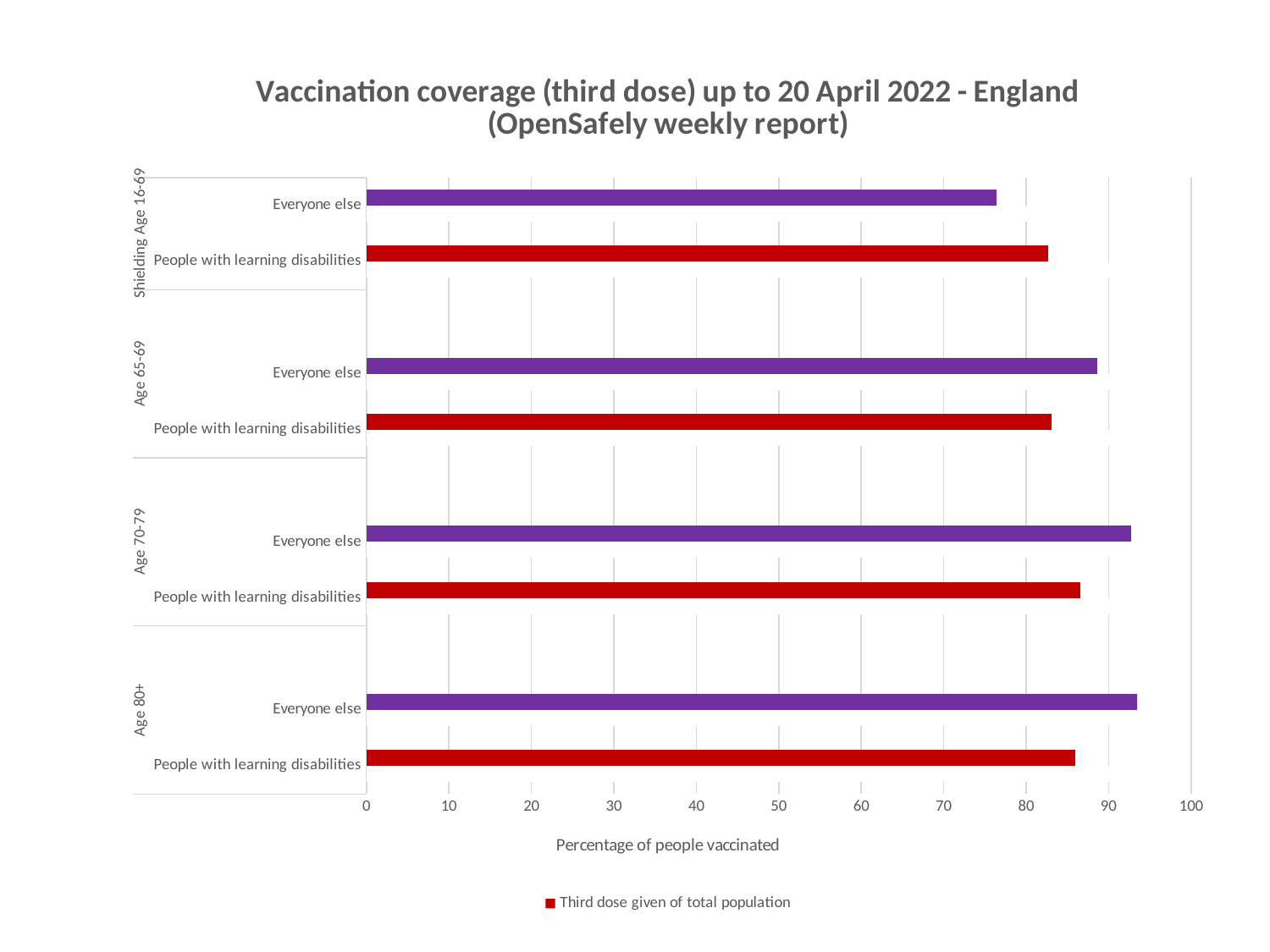
Is the value for Everyone else in the Age 65-69 group greater or less than 90? less How many series does the legend list? 1 Is the value for Everyone else in the Age 80+ group greater or less than 90? greater What is the title of the horizontal axis of the chart? Percentage of people vaccinated Is the value for People with learning disabilities in the Age 80+ group greater or less than 80? greater How many bars are plotted in the chart? 8 What kind of chart is shown on the slide? Bar chart In the Age 70-79 group, which is larger: the value for People with learning disabilities or for Everyone else? Everyone else In the Shielding Age 16-69 group, which is larger: the value for People with learning disabilities or for Everyone else? People with learning disabilities Which bar has the lowest value in the chart? Everyone else, Shielding Age 16-69 How many age groups are shown on the vertical axis of the chart? 4